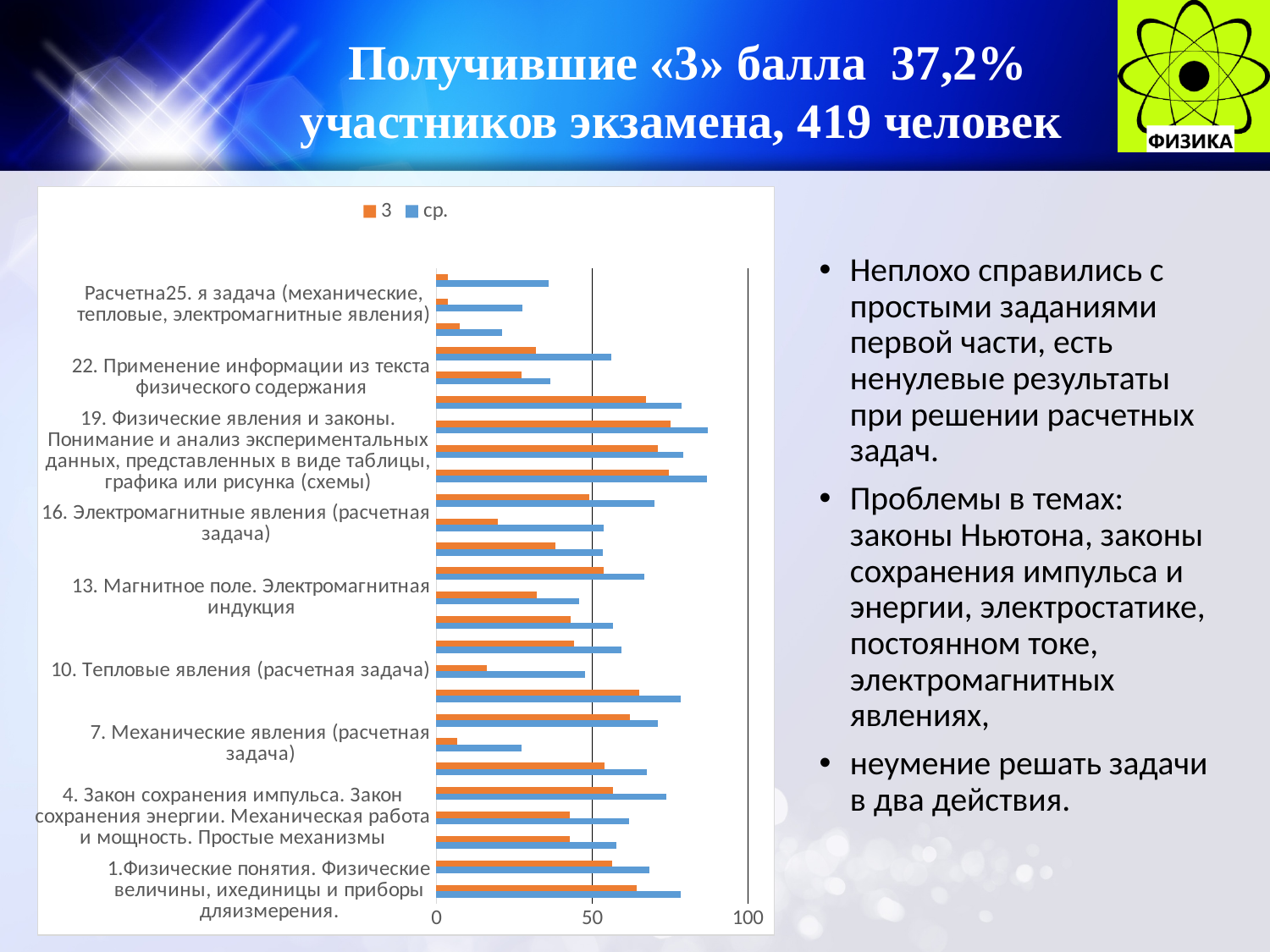
For "10. Тепловые явления (расчетная задача)", which series has the larger value, "3" or "ср."? ср. Is the value of series "ср." for "1.Физические понятия. Физические величины, их единицы и приборы для измерения" greater or less than 50? greater How many series does the chart legend list? 2 Is the value of series "ср." for "19. Физические явления и законы. Понимание и анализ экспериментальных данных..." greater or less than 50? greater What kind of chart is shown on the slide? bar chart Is the value of series "3" for "25. Расчетная задача (механические, тепловые, электромагнитные явления)" greater or less than 50? less What are the two series named in the chart legend? 3 and ср. What is the highest value shown on the chart's horizontal axis? 100 For "7. Механические явления (расчетная задача)", which series has the larger value, "3" or "ср."? ср.